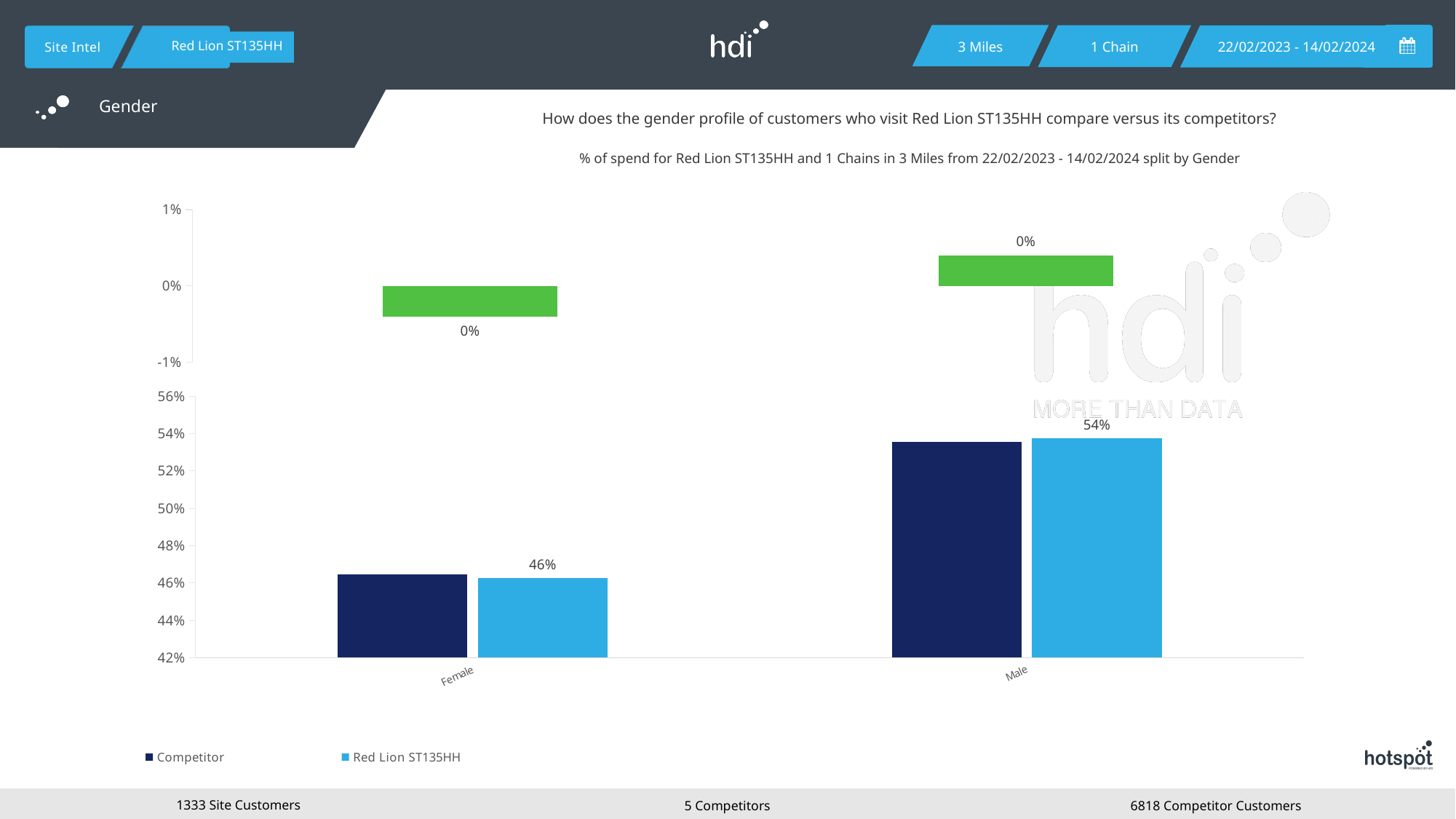
What is the value for Red Lion ST135HH in the Female category? 46% How many series does the legend list? 2 Is the Competitor value for Male greater or less than 52%? greater How many gender categories are shown on the x axis? 2 Which gender category has the higher value for Red Lion ST135HH? Male What is the difference between the Red Lion ST135HH Male value and its Female value? 8% What are the two entries in the chart legend? Competitor and Red Lion ST135HH What is the value for Red Lion ST135HH in the Male category? 54% Is the Competitor value for Female greater or less than 48%? less Is the Red Lion ST135HH value larger for Male or for Female? Male Which gender category has the lower value for Red Lion ST135HH? Female What kind of chart is shown on the slide? bar chart